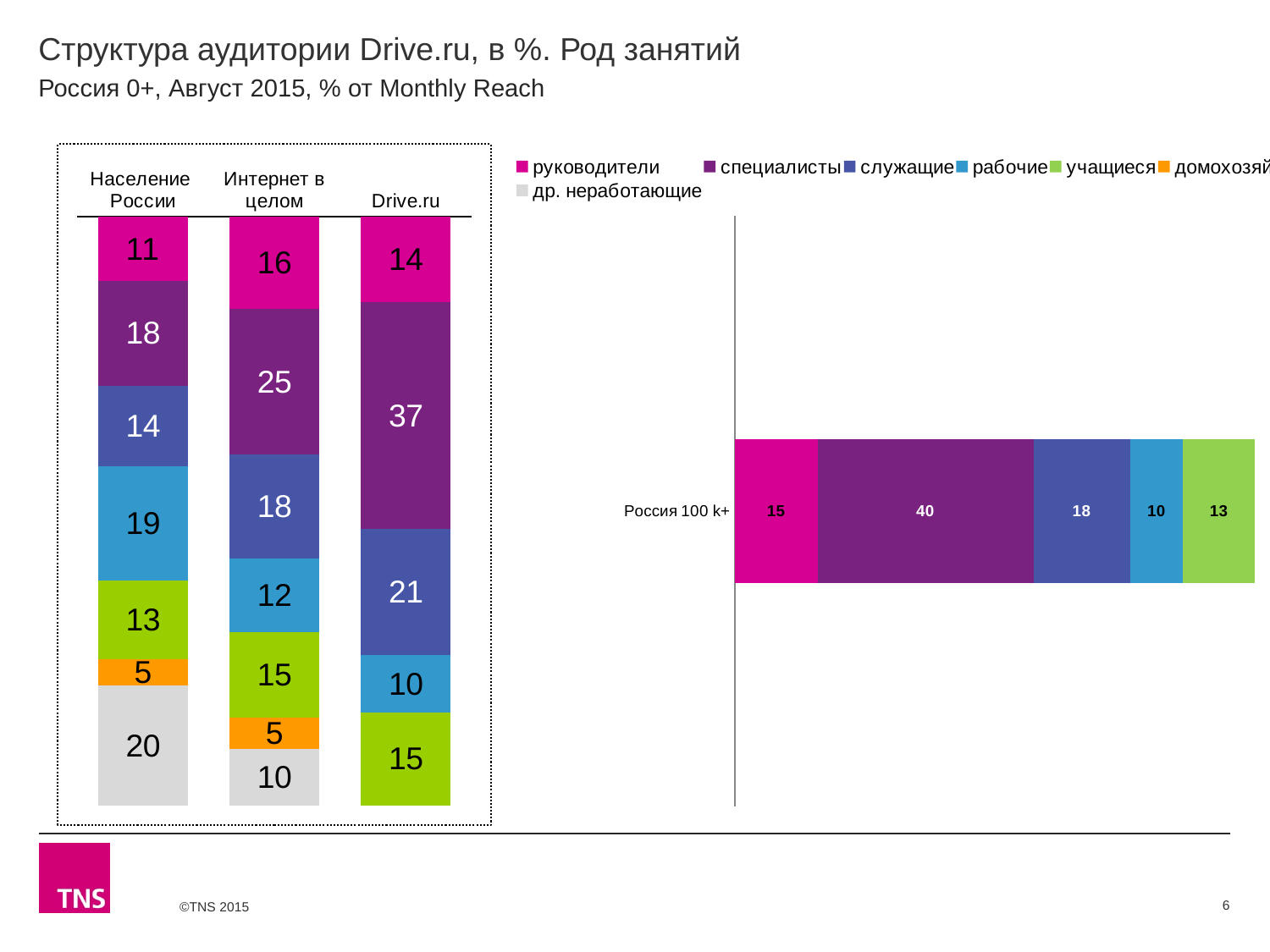
In the left chart, what is the difference between the специалисты values for Drive.ru and Население России? 19 In the left chart, what is the value of the специалисты segment for Drive.ru? 37 In the right chart, which segment is the smallest for Россия 100 k+? рабочие How many bars does the left chart show? 3 In the left chart, which segment is the largest in the Drive.ru bar? специалисты How many series does the legend list? 7 In the left chart, what is the value of the руководители segment for Интернет в целом? 16 In the right chart, what is the value of the специалисты segment for Россия 100 k+? 40 In the right chart, what is the total of the Россия 100 k+ bar? 96 What type of chart is the right chart? Stacked bar chart In the left chart, which is larger: the служащие value for Drive.ru or for Интернет в целом? Drive.ru In the left chart, what is the value of the др. неработающие segment for Население России? 20